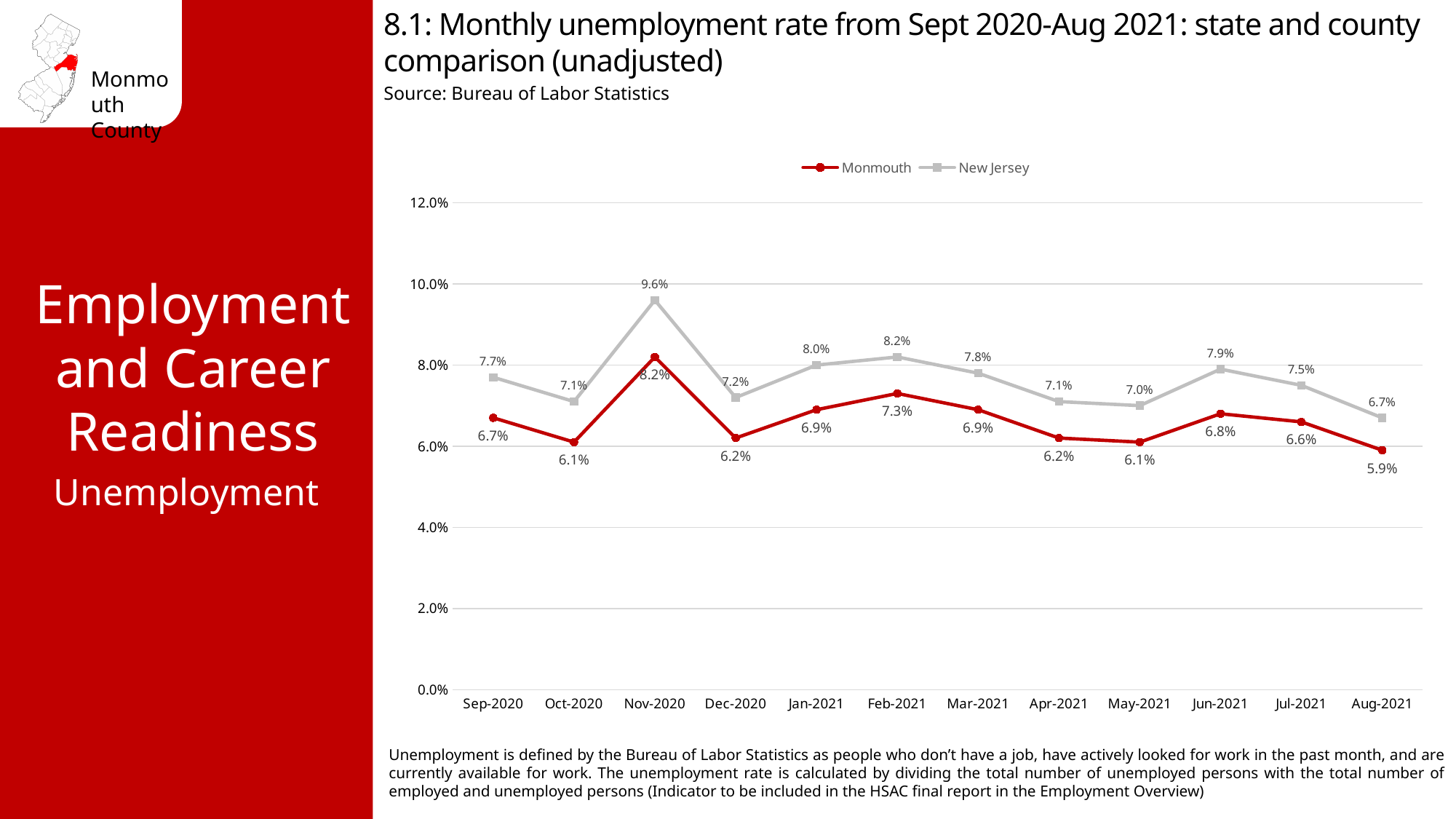
In which month did New Jersey have its highest unemployment rate? Nov-2020 Did the Monmouth unemployment rate rise or fall from Jun-2021 to Aug-2021? Fall How many months are plotted on the x axis? 12 What is the difference between the New Jersey and Monmouth unemployment rates in Nov-2020? 1.4 percentage points Which had the higher unemployment rate in Feb-2021, Monmouth or New Jersey? New Jersey In which month did Monmouth have its lowest unemployment rate? Aug-2021 How many series does the legend list? 2 What was the Monmouth unemployment rate in Aug-2021? 5.9% What kind of chart is shown on the slide? Line chart What was the New Jersey unemployment rate in Jan-2021? 8.0% What was the Monmouth unemployment rate in Nov-2020? 8.2% What colour is the Monmouth line in the chart? Red